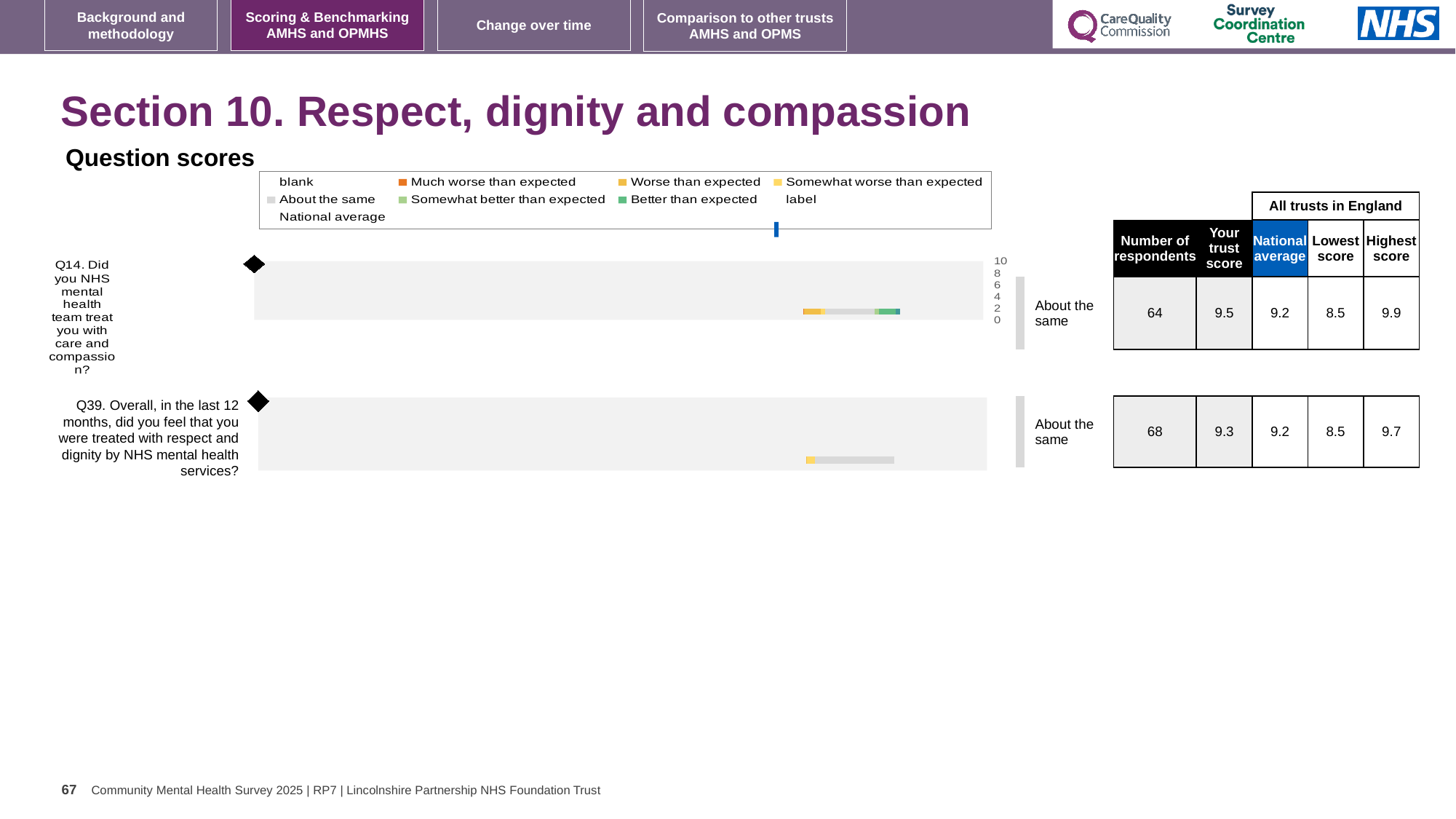
What is the national average for Q14? 9.2 What benchmark category is shown for Q14 in the question scores chart? About the same How many entries does the legend of the question scores chart list? 9 What is the highest score among all trusts in England for Q39? 9.7 What is the difference between the highest and lowest scores for Q39? 1.2 What kind of chart is used to show the question scores on this slide? bar chart What is the difference between the trust score and the national average for Q14? 0.3 What is the trust score for Q39 (respect and dignity)? 9.3 How many respondents answered Q39? 68 Which question has the higher trust score, Q14 or Q39? Q14 How many questions are plotted in the question scores chart? 2 What is the trust score for Q14 (care and compassion)? 9.5